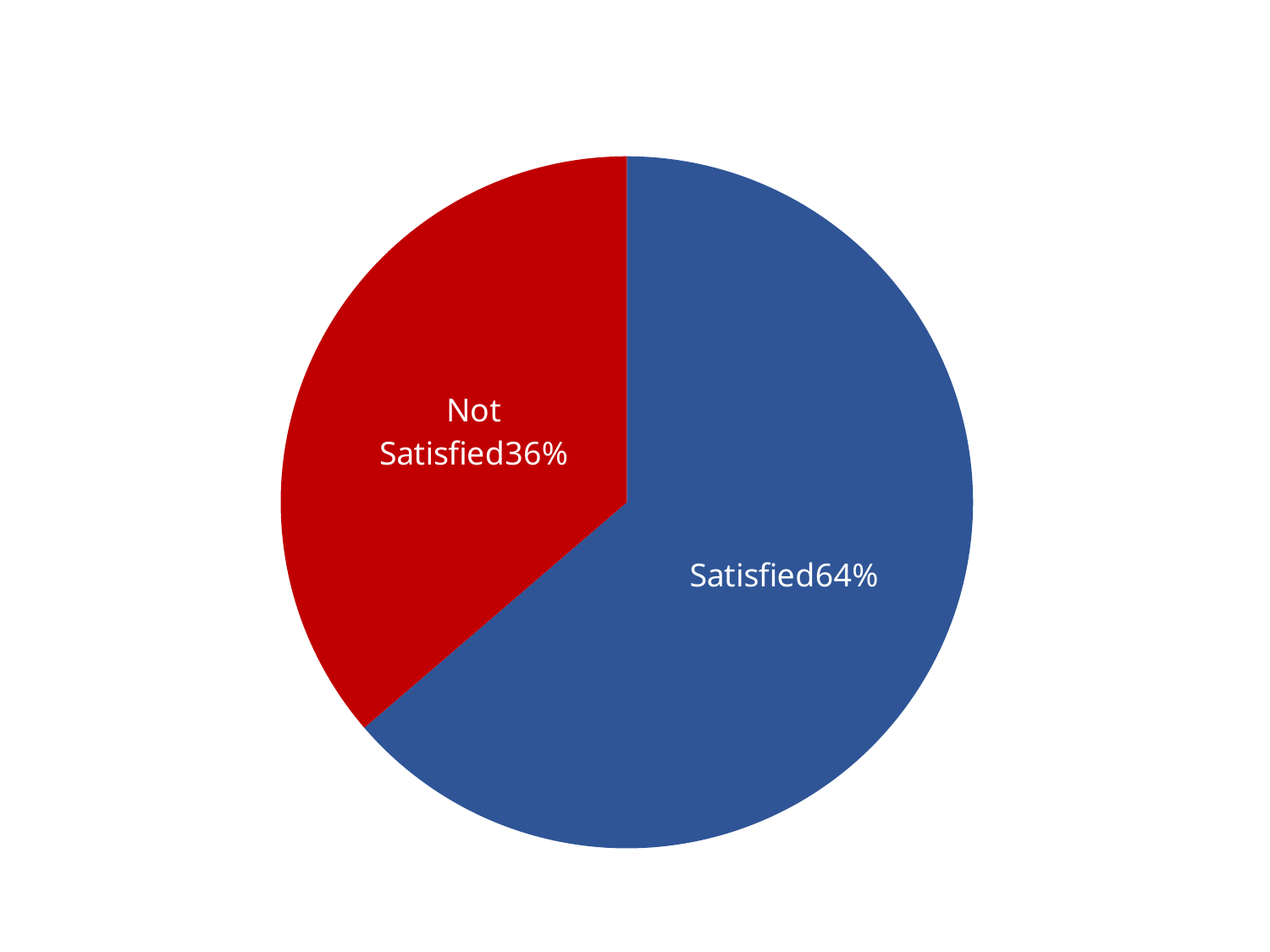
What colour is the Not Satisfied slice? red Which slice of the pie is the largest? Satisfied What kind of chart is shown on the slide? pie chart How many slices does the pie chart have? 2 What is the difference in percentage points between the Satisfied and Not Satisfied slices? 28 What share of the pie is labelled Satisfied? 64% Which is larger, the Satisfied slice or the Not Satisfied slice? Satisfied What share of the pie is labelled Not Satisfied? 36% What colour is the Satisfied slice? blue Which slice of the pie is the smallest? Not Satisfied